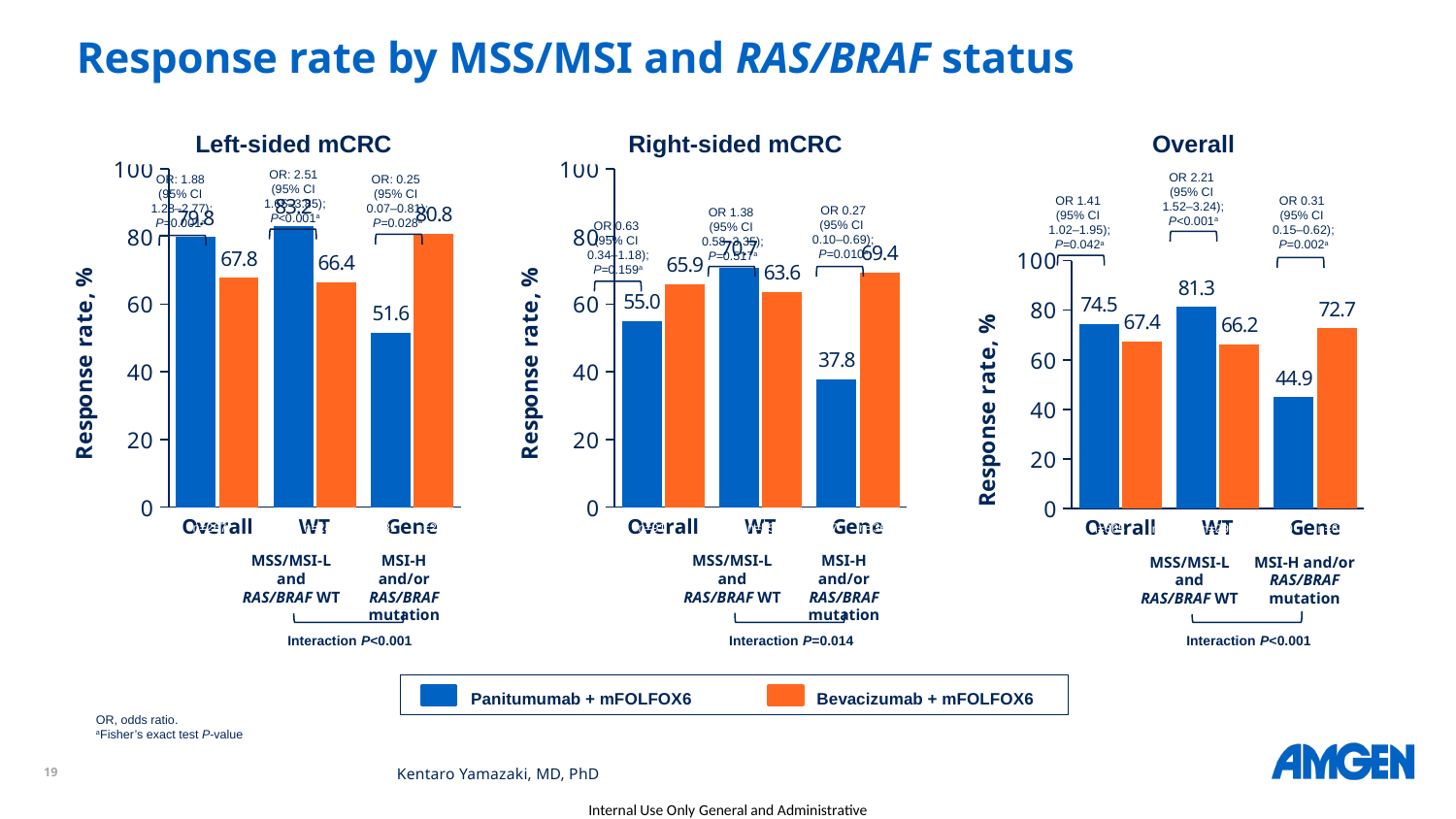
How many series does the shared legend list? 2 What type of chart is used for the Left-sided mCRC panel? Bar chart In the Right-sided mCRC chart, what is the response rate for Bevacizumab + mFOLFOX6 in the Overall category? 65.9 In the Overall chart, what is the difference between the Panitumumab + mFOLFOX6 and Bevacizumab + mFOLFOX6 response rates in the WT category? 15.1 In the Overall chart, what is the response rate for Bevacizumab + mFOLFOX6 in the Gene category? 72.7 In the Right-sided mCRC chart, which treatment has the higher response rate in the Overall category? Bevacizumab + mFOLFOX6 In the Right-sided mCRC chart, what is the response rate for Panitumumab + mFOLFOX6 in the Gene category? 37.8 In the Left-sided mCRC chart, is the response rate for Panitumumab + mFOLFOX6 in the WT category greater or less than 80? greater In the Overall chart, which category has the lowest response rate for Panitumumab + mFOLFOX6? Gene In the Left-sided mCRC chart, what is the response rate for Panitumumab + mFOLFOX6 in the Gene category? 51.6 In the Overall chart, what is the response rate for Panitumumab + mFOLFOX6 in the Overall category? 74.5 In the Left-sided mCRC chart, what is the response rate for Bevacizumab + mFOLFOX6 in the WT category? 66.4